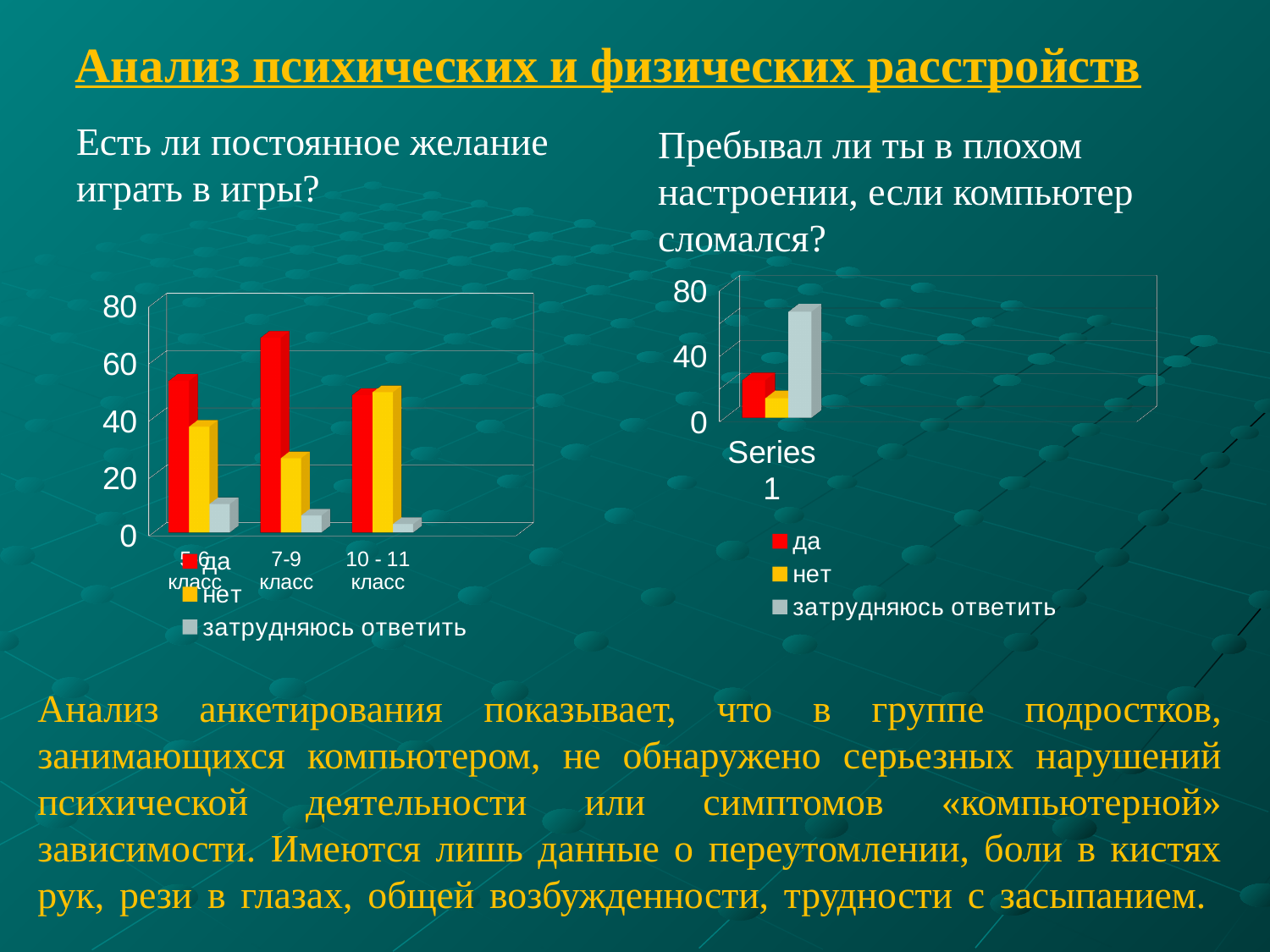
On the left chart 'Есть ли постоянное желание играть в игры?', which is larger for 7-9 класс: 'да' or 'нет'? да On the left chart 'Есть ли постоянное желание играть в игры?', how many series does the legend list? 3 On the left chart 'Есть ли постоянное желание играть в игры?', how many class-group categories are shown on the x axis? 3 On the left chart 'Есть ли постоянное желание играть в игры?', is the value for 'да' in 7-9 класс greater or less than 60? greater On the right chart 'Пребывал ли ты в плохом настроении, если компьютер сломался?', how many series does the legend list? 3 On the left chart 'Есть ли постоянное желание играть в игры?', is the value for 'затрудняюсь ответить' in 10 - 11 класс greater or less than 20? less On the left chart 'Есть ли постоянное желание играть в игры?', which series is shown in yellow? нет On the left chart 'Есть ли постоянное желание играть в игры?', which class group has the highest value for 'да'? 7-9 класс On the left chart 'Есть ли постоянное желание играть в игры?', what kind of chart is shown? bar chart On the right chart 'Пребывал ли ты в плохом настроении, если компьютер сломался?', which answer has the highest value? затрудняюсь ответить On the right chart 'Пребывал ли ты в плохом настроении, если компьютер сломался?', is the value for 'затрудняюсь ответить' greater or less than 40? greater On the right chart 'Пребывал ли ты в плохом настроении, если компьютер сломался?', which answer has the lowest value? нет